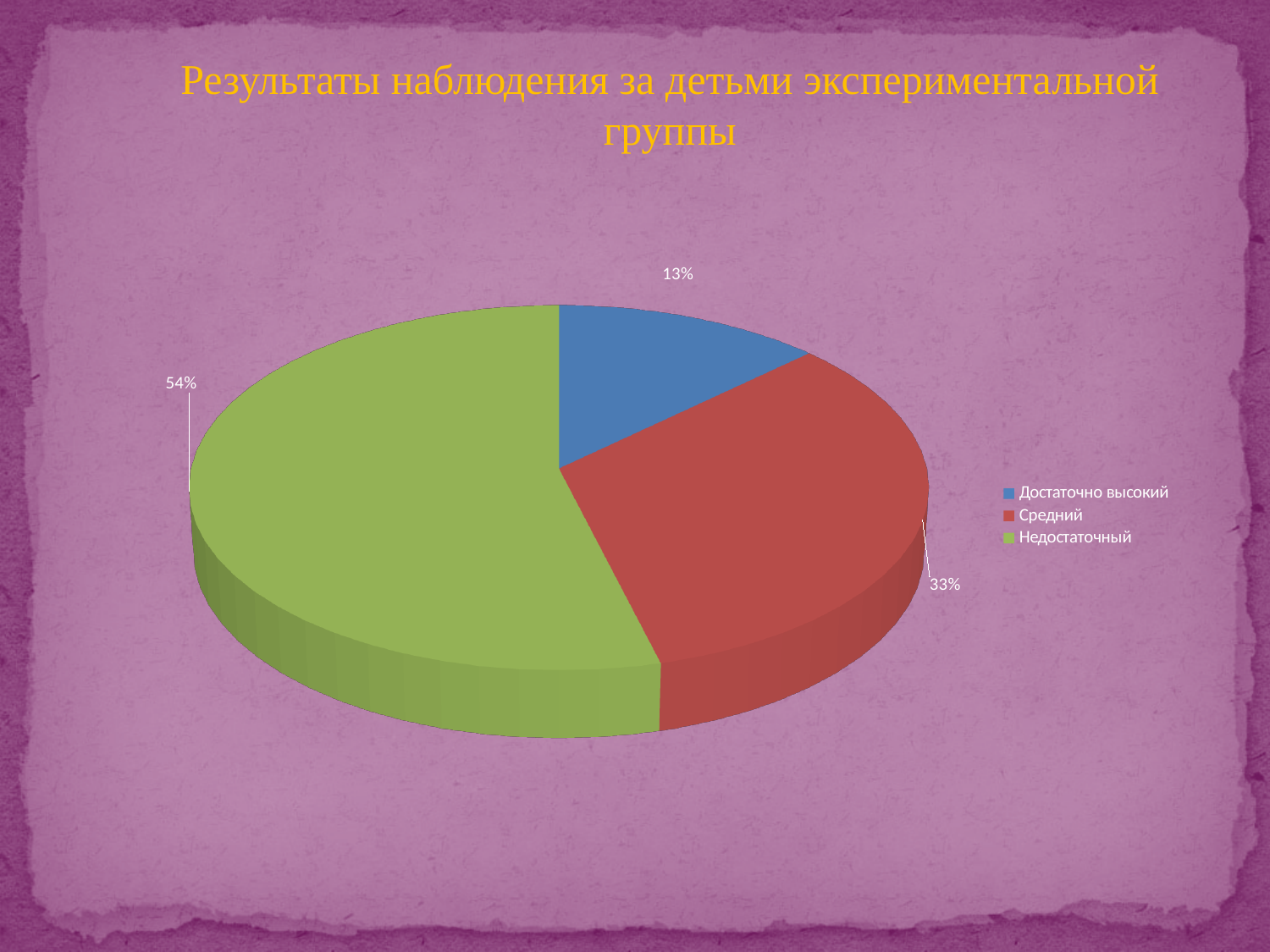
What share of the pie does "Недостаточный" have? 54% What is the difference in percentage points between "Недостаточный" and "Средний"? 21 Which category has the largest slice of the pie? Недостаточный What kind of chart is shown on the slide? pie chart Which category has the smallest slice of the pie? Достаточно высокий How many categories does the pie chart have? 3 What share of the pie does "Средний" have? 33% What colour is the slice for "Средний"? red What is the difference in percentage points between "Средний" and "Достаточно высокий"? 20 What is the title of the chart on the slide? Результаты наблюдения за детьми экспериментальной группы What share of the pie does "Достаточно высокий" have? 13% Which is larger, the slice for "Средний" or the slice for "Достаточно высокий"? Средний